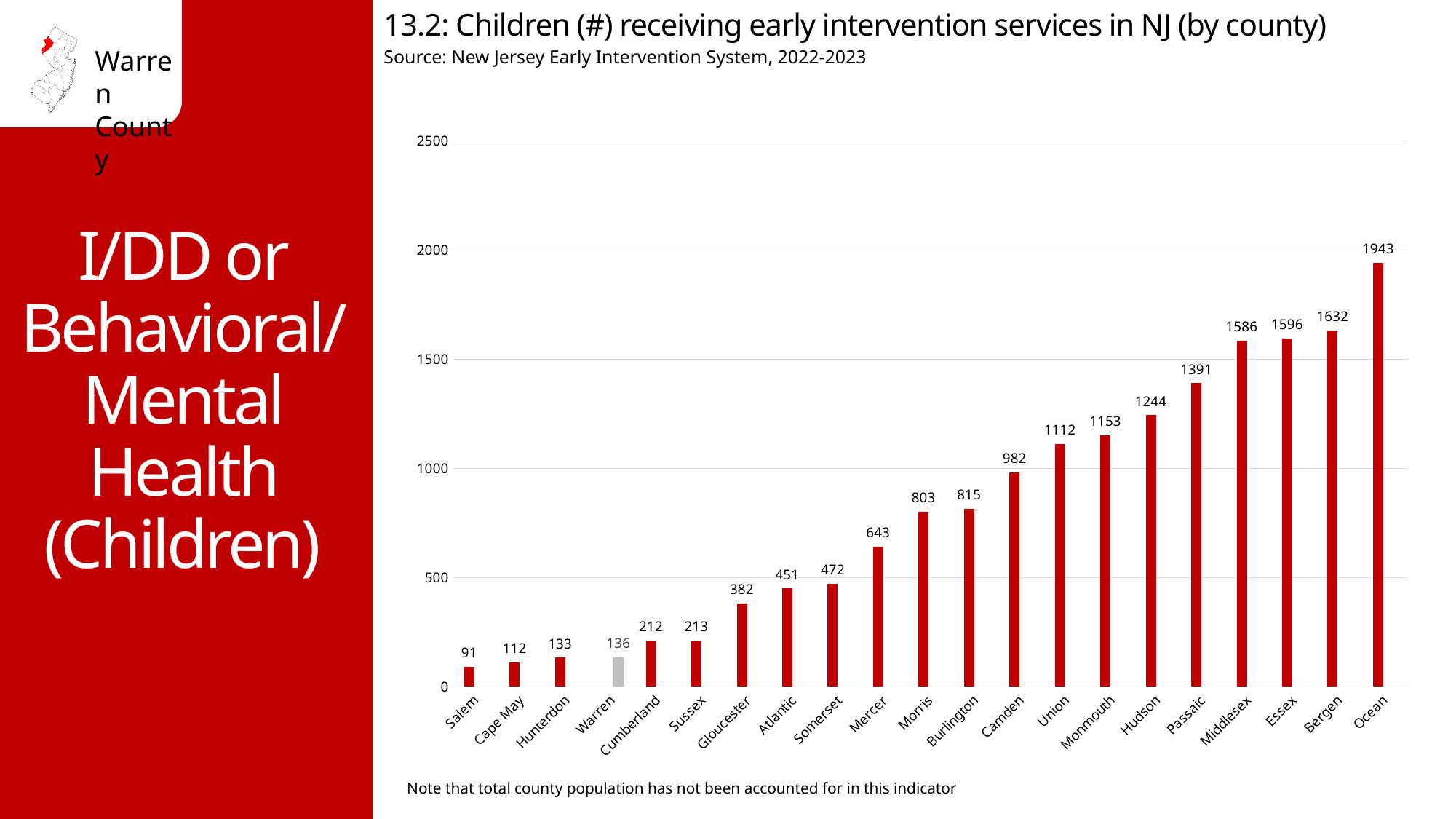
What is the value shown for Gloucester? 382 What kind of chart is shown on the slide? Bar chart Which county has the lowest number of children receiving early intervention services? Salem Do the values rise or fall moving from left to right along the x axis? Rise How many counties are shown on the x axis? 21 Which bar is coloured differently (grey) from the others? Warren What is the difference between the values for Warren and Hunterdon? 3 Which has a larger value, Mercer or Morris? Morris Which county has the highest number of children receiving early intervention services? Ocean How many children received early intervention services in Warren County? 136 What is the value shown for Camden? 982 What is the difference between the values for Ocean and Bergen? 311